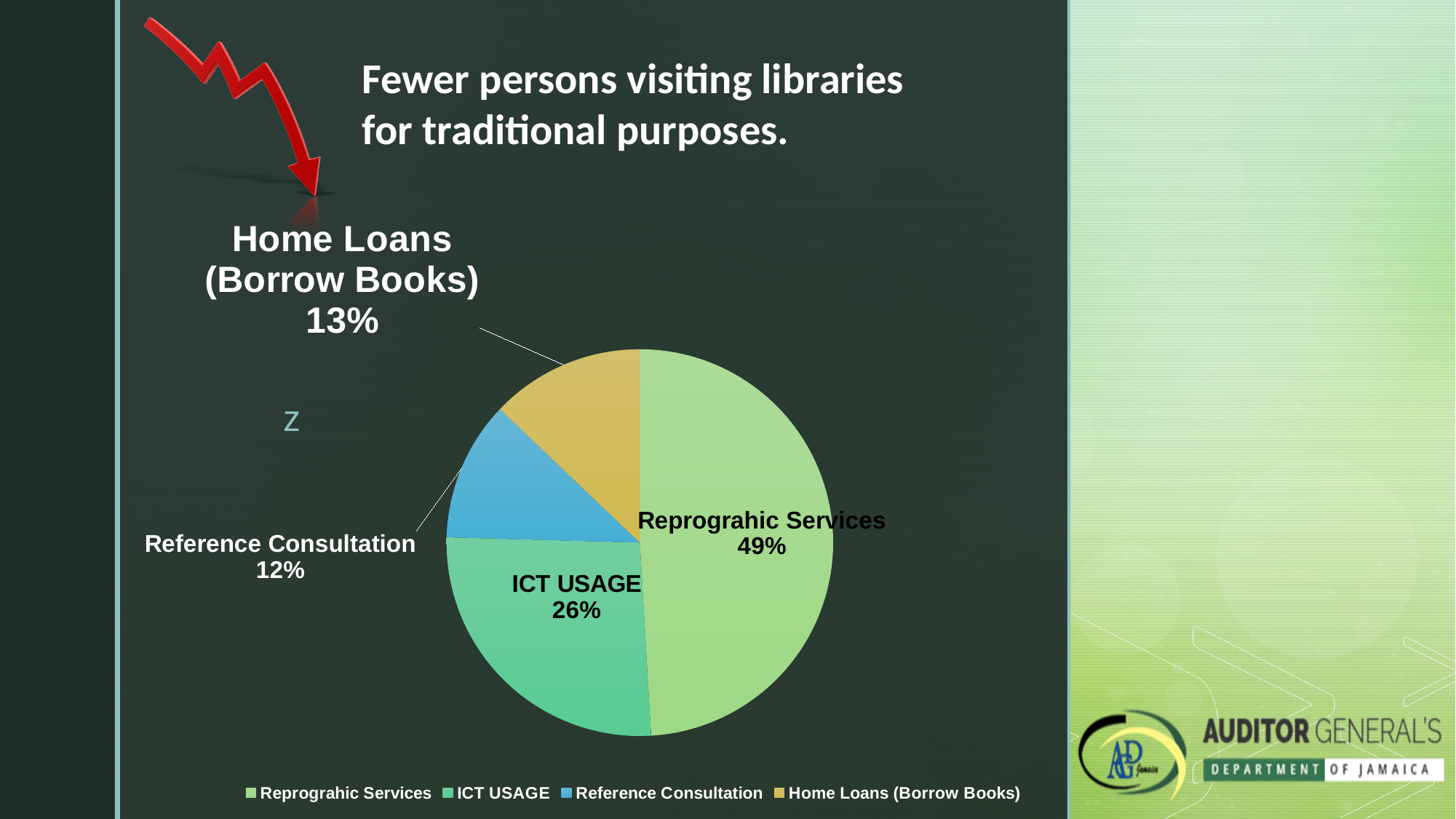
What share of the pie does Reprograhic Services account for? 49% What kind of chart is shown on the slide? pie chart What is the difference in percentage points between Reprograhic Services and ICT USAGE? 23 Which category has the smallest slice of the pie? Reference Consultation Which category has the largest slice of the pie? Reprograhic Services What colour is the Reference Consultation slice? blue How many entries does the legend list? 4 What percentage is shown for Home Loans (Borrow Books)? 13% How many slices does the pie chart have? 4 What percentage is shown for Reference Consultation? 12% What percentage is shown for ICT USAGE? 26% Which is larger, the share for Home Loans (Borrow Books) or the share for Reference Consultation? Home Loans (Borrow Books)